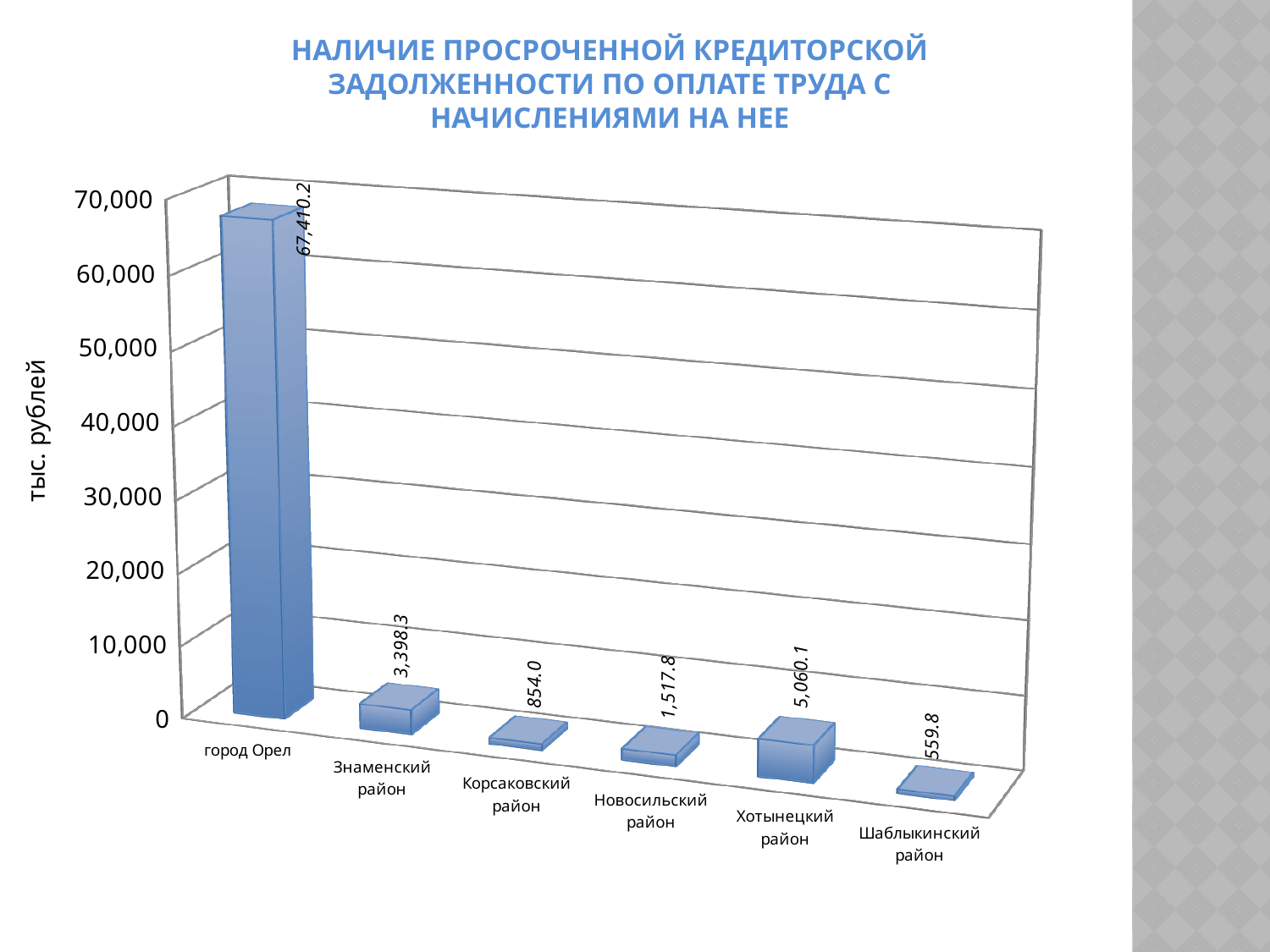
What is the value for город Орел? 67,410.2 What is the value for Корсаковский район? 854.0 Which is larger, the value for Знаменский район or the value for Новосильский район? Знаменский район Is the value for город Орел greater or less than 60,000? greater What is the value for Шаблыкинский район? 559.8 What unit is shown on the vertical axis label? тыс. рублей How many categories are shown on the chart? 6 What is the difference between the values for Новосильский район and Корсаковский район? 663.8 What is the value for Хотынецкий район? 5,060.1 What is the difference between the values for Хотынецкий район and Знаменский район? 1,661.8 Which category has the highest value? город Орел Which category has the lowest value? Шаблыкинский район